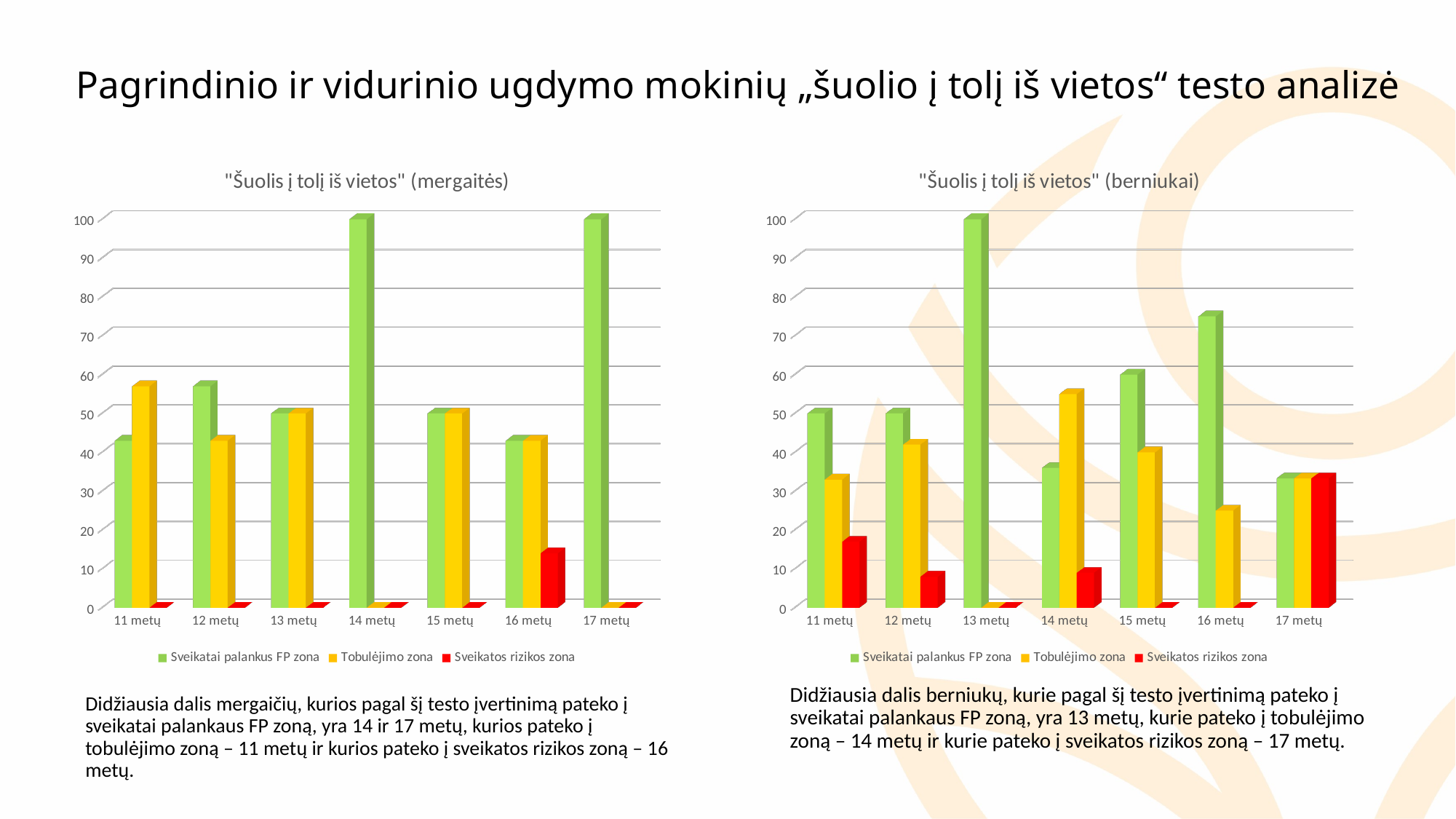
In the "Šuolis į tolį iš vietos" (mergaitės) chart, is the Tobulėjimo zona value for 11 metų greater or less than 50? greater In the "Šuolis į tolį iš vietos" (berniukai) chart, what is the value of Sveikatai palankus FP zona for 13 metų? 100 How many age groups are shown on the x axis of the "Šuolis į tolį iš vietos" (mergaitės) chart? 7 In the "Šuolis į tolį iš vietos" (berniukai) chart, is the Sveikatos rizikos zona value for 11 metų greater or less than 10? greater How many series does the legend of the "Šuolis į tolį iš vietos" (berniukai) chart list? 3 In the "Šuolis į tolį iš vietos" (berniukai) chart, which age group has the highest Sveikatos rizikos zona value? 17 metų In the "Šuolis į tolį iš vietos" (mergaitės) chart, which age groups have the highest Sveikatai palankus FP zona value? 14 metų and 17 metų In the "Šuolis į tolį iš vietos" (berniukai) chart, is the Sveikatai palankus FP zona value for 16 metų greater or less than 70? greater In the "Šuolis į tolį iš vietos" (mergaitės) chart, what is the value of Sveikatai palankus FP zona for 14 metų? 100 In the "Šuolis į tolį iš vietos" (mergaitės) chart, which age group has the highest Sveikatos rizikos zona value? 16 metų In the "Šuolis į tolį iš vietos" (berniukai) chart, what is the value of Sveikatos rizikos zona for 13 metų? 0 In the "Šuolis į tolį iš vietos" (berniukai) chart, which is larger for 15 metų: Sveikatai palankus FP zona or Tobulėjimo zona? Sveikatai palankus FP zona